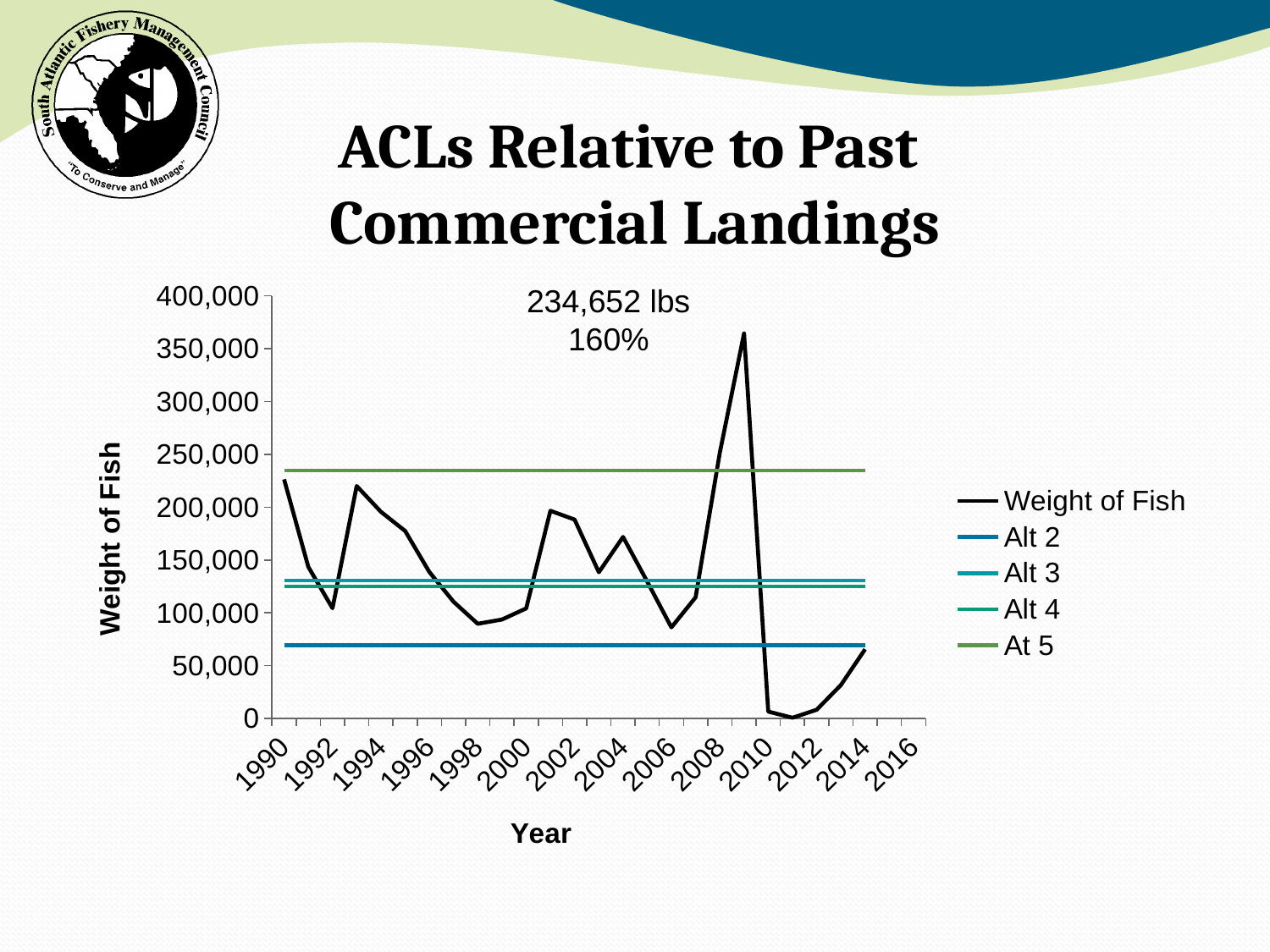
Is the Weight of Fish value in 2011 greater or less than 50,000? less In which year does the Weight of Fish series reach its highest value? 2009 What kind of chart is shown on the slide? line chart Is the Weight of Fish value in 2009 greater or less than 300,000? greater What is the label of the y axis? Weight of Fish Is the Alt 2 line greater or less than 100,000? less Does the Weight of Fish series rise or fall between 2009 and 2011? fall What is the title of the chart? ACLs Relative to Past Commercial Landings Which year has a higher Weight of Fish value, 1990 or 1992? 1990 How many series does the legend list? 5 Which is higher, the Alt 2 line or the At 5 line? At 5